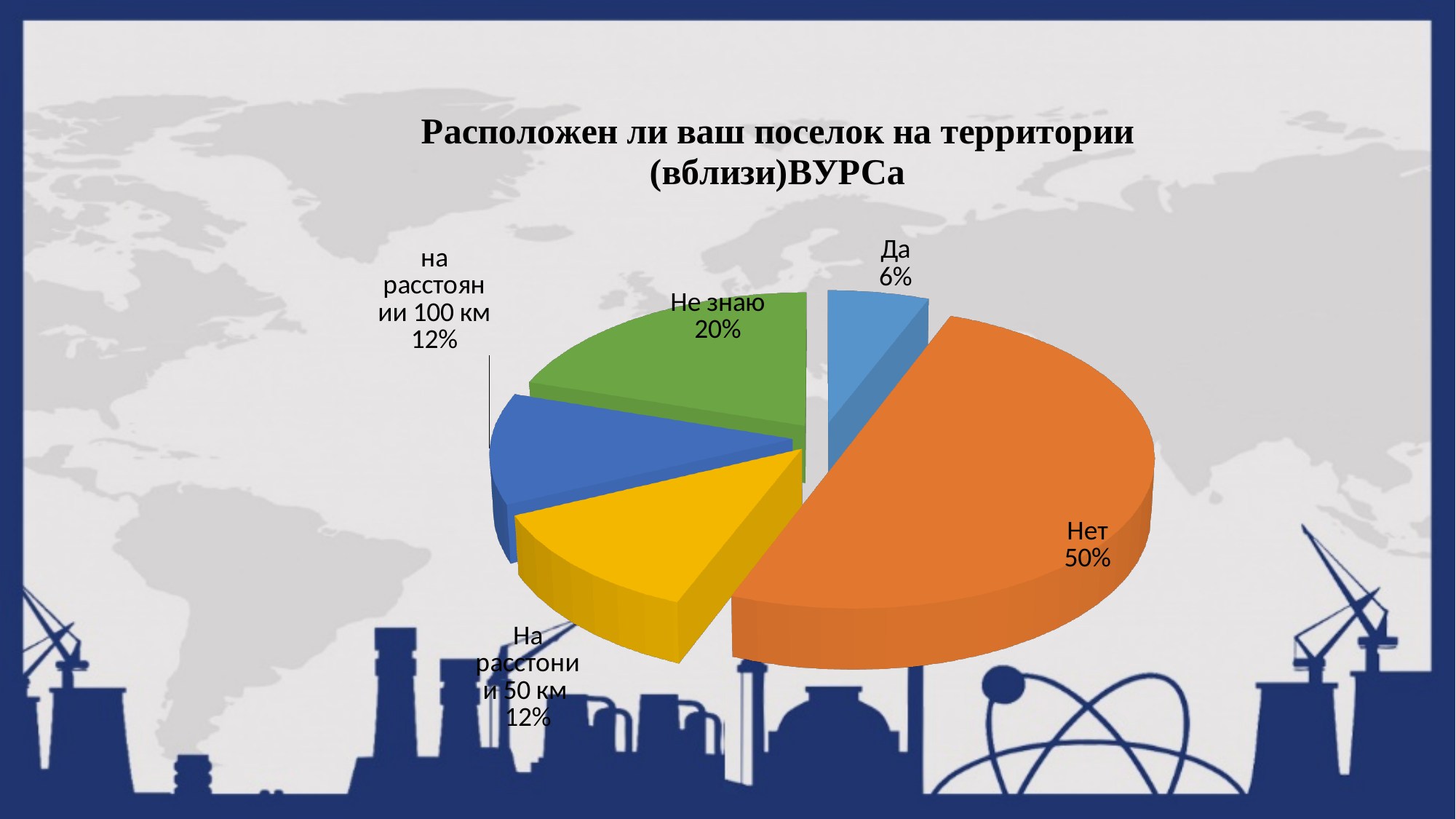
Which category has the largest slice of the pie? Нет Which category has the smallest slice of the pie? Да What share of the pie does the "Нет" slice represent? 50% What share of the pie does the "на расстоянии 100 км" slice represent? 12% How many slices does the pie chart have? 5 What share of the pie does the "Не знаю" slice represent? 20% What colour is the "Нет" slice? Orange What type of chart is shown on the slide? Pie chart Which is larger, the "Не знаю" slice or the "На расстонии 50 км" slice? Не знаю What is the difference in percentage points between the "Нет" slice and the "Не знаю" slice? 30% What is the title of the chart? Расположен ли ваш поселок на территории (вблизи)ВУРСа